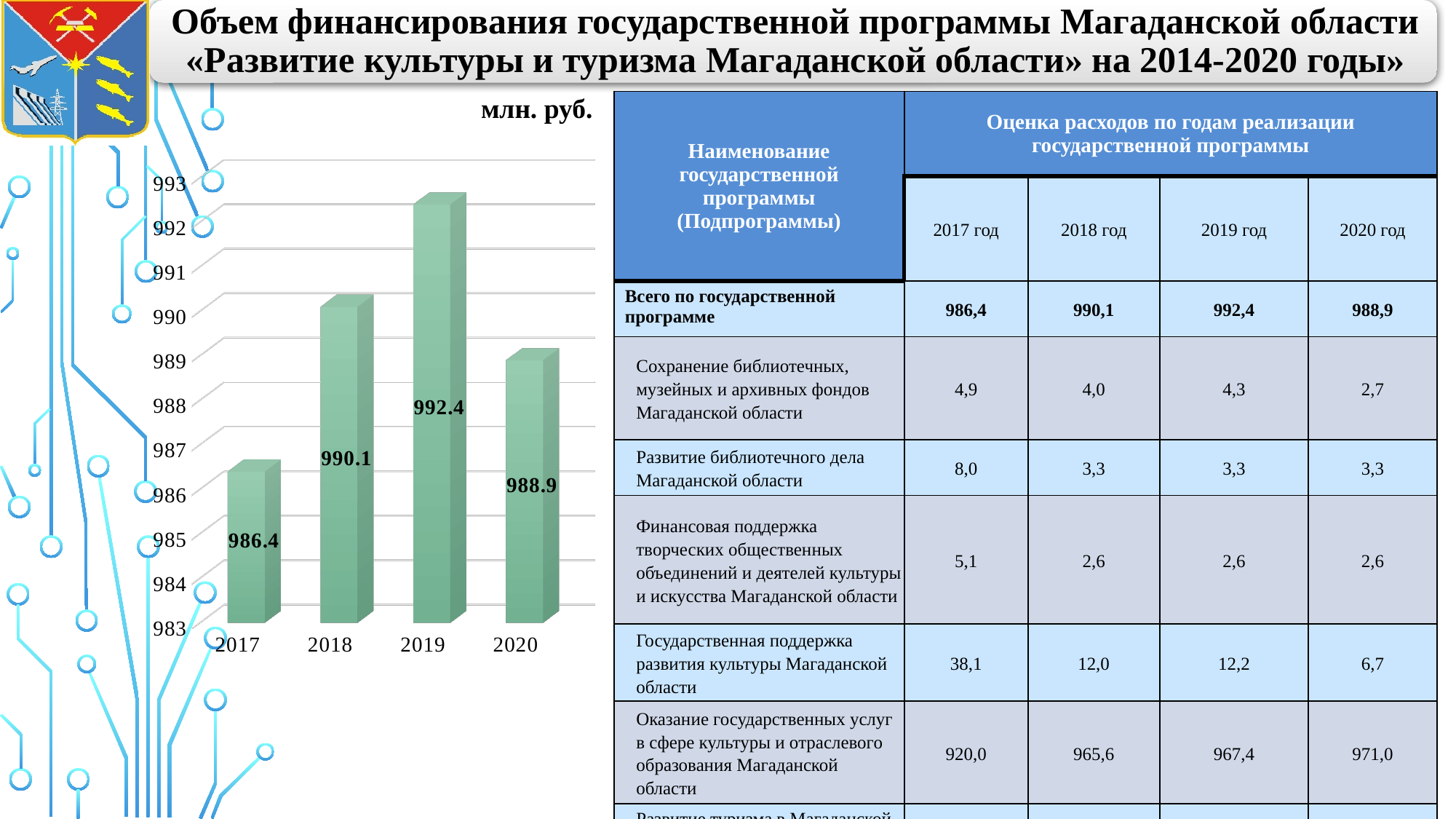
What is the value for 2020 in the bar chart? 988.9 What is the value for 2019 in the bar chart? 992.4 What unit label is shown above the bar chart? млн. руб. What is the difference between the values for 2019 and 2017 in the bar chart? 6 Which year has the highest value in the bar chart? 2019 Which year has the lowest value in the bar chart? 2017 What is the value for 2018 in the bar chart? 990.1 What is the value for 2017 in the bar chart? 986.4 Which is larger in the bar chart, the value for 2018 or the value for 2020? 2018 How many years are shown on the x axis of the bar chart? 4 What kind of chart is shown on the slide? bar chart What is the difference between the values for 2018 and 2020 in the bar chart? 1.2